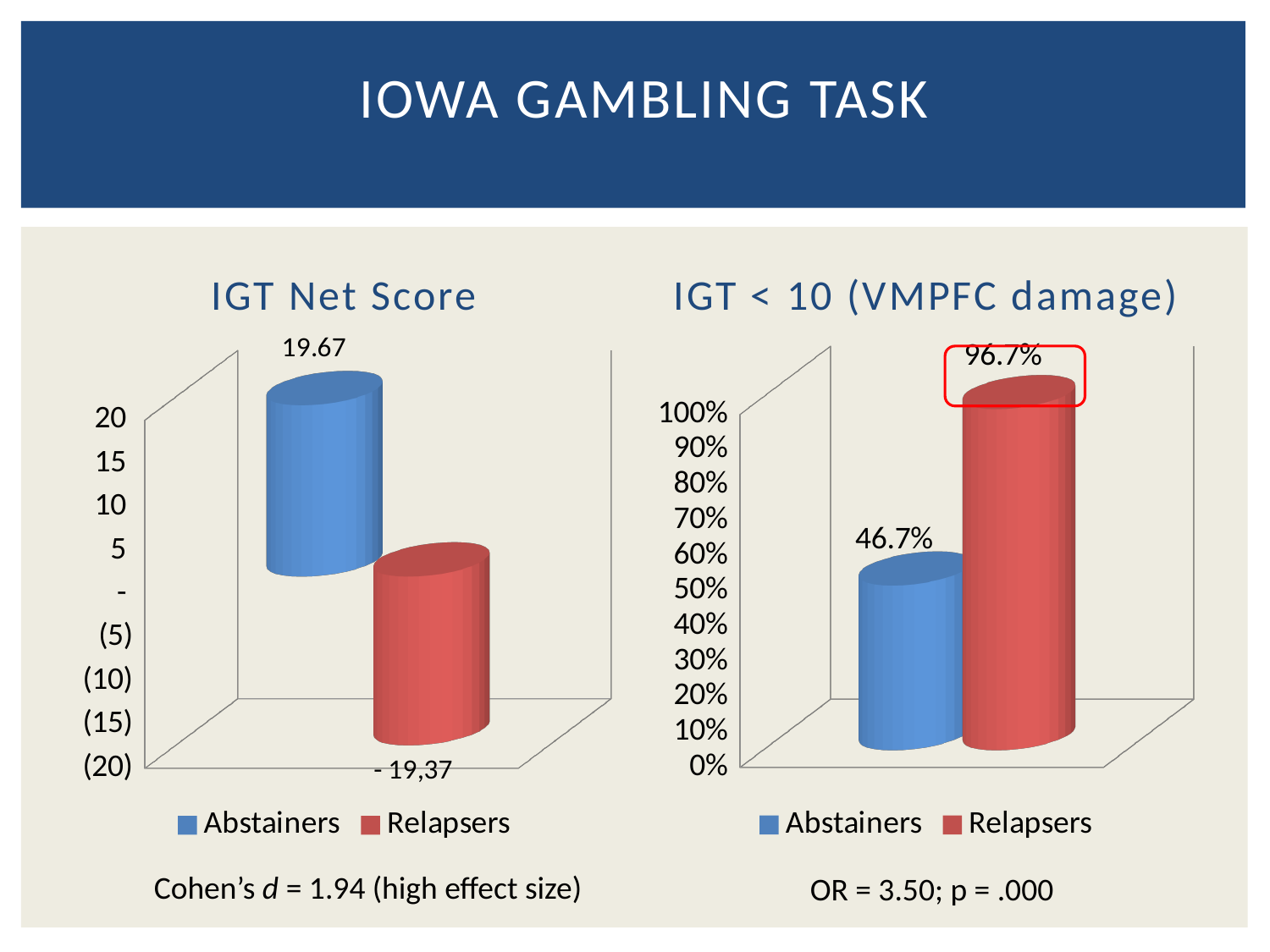
In the IGT Net Score chart, is the value for Relapsers greater or less than 0? less In the IGT Net Score chart, what colour represents Relapsers? red In the IGT < 10 (VMPFC damage) chart, is the value for Abstainers greater or less than 50%? less In the IGT Net Score chart, what is the value for Abstainers? 19.67 In the IGT Net Score chart, what is the value for Relapsers? - 19,37 What kind of chart is the IGT < 10 (VMPFC damage) chart? bar chart In the IGT Net Score chart, which group has the higher value? Abstainers In the IGT < 10 (VMPFC damage) chart, what is the value for Relapsers? 96.7% How many series does the legend of the IGT Net Score chart list? 2 In the IGT < 10 (VMPFC damage) chart, which group has the lower value? Abstainers In the IGT < 10 (VMPFC damage) chart, what is the value for Abstainers? 46.7% In the IGT < 10 (VMPFC damage) chart, what is the difference between the Relapsers and Abstainers values? 50%